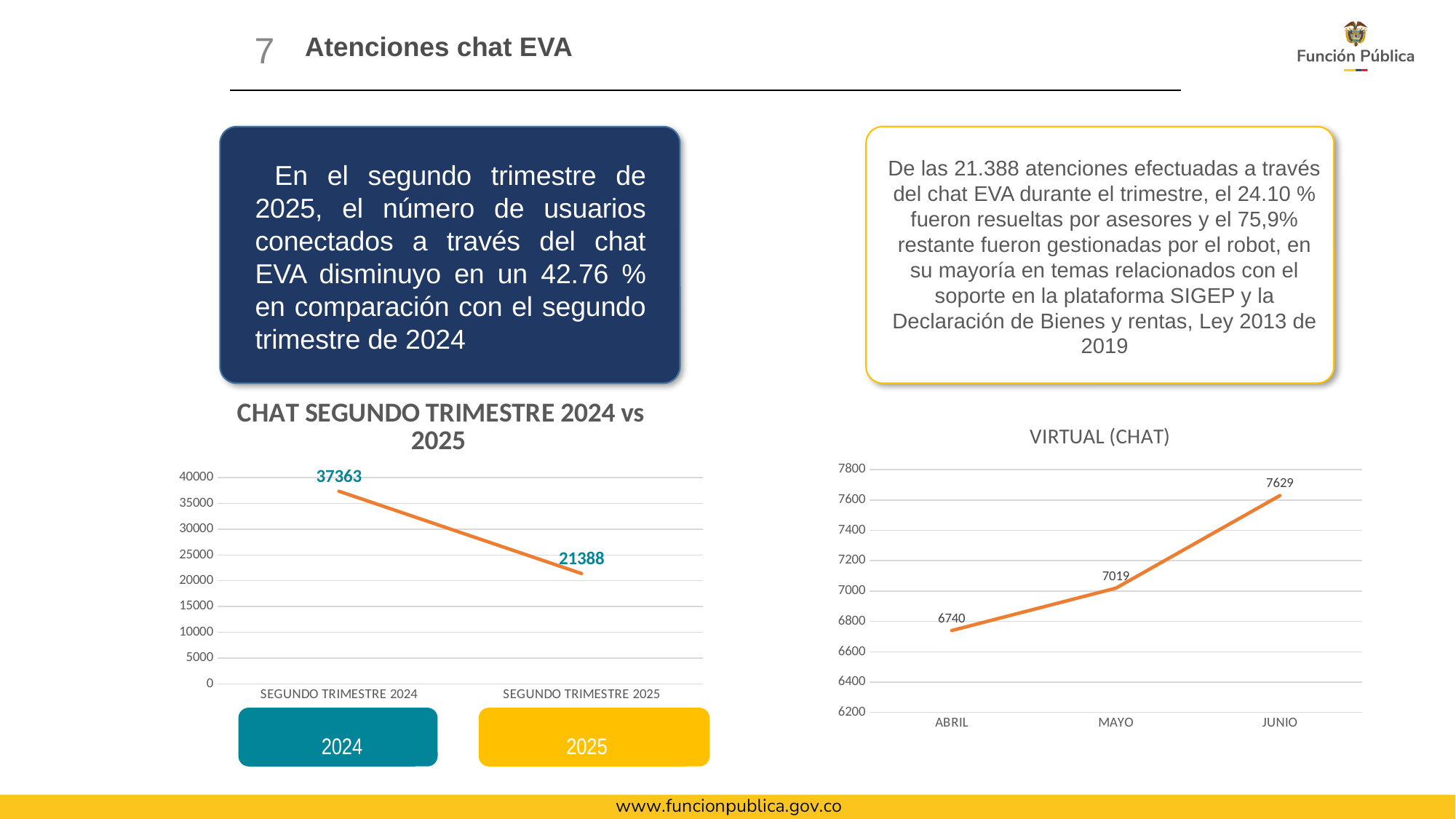
In the 'CHAT SEGUNDO TRIMESTRE 2024 vs 2025' chart, what is the difference between the 2024 and 2025 values? 15975 In the 'VIRTUAL (CHAT)' chart, which month has the highest value? JUNIO What kind of chart is the 'CHAT SEGUNDO TRIMESTRE 2024 vs 2025' chart? line chart In the 'VIRTUAL (CHAT)' chart, what is the value for MAYO? 7019 In the 'VIRTUAL (CHAT)' chart, which month has the lowest value? ABRIL How many months are plotted in the 'VIRTUAL (CHAT)' chart? 3 In the 'VIRTUAL (CHAT)' chart, what is the value for ABRIL? 6740 In the 'CHAT SEGUNDO TRIMESTRE 2024 vs 2025' chart, what is the value for SEGUNDO TRIMESTRE 2025? 21388 In the 'VIRTUAL (CHAT)' chart, what is the difference between the JUNIO and ABRIL values? 889 In the 'CHAT SEGUNDO TRIMESTRE 2024 vs 2025' chart, what is the value for SEGUNDO TRIMESTRE 2024? 37363 In the 'VIRTUAL (CHAT)' chart, what is the value for JUNIO? 7629 In the 'CHAT SEGUNDO TRIMESTRE 2024 vs 2025' chart, do the values rise or fall from 2024 to 2025? fall